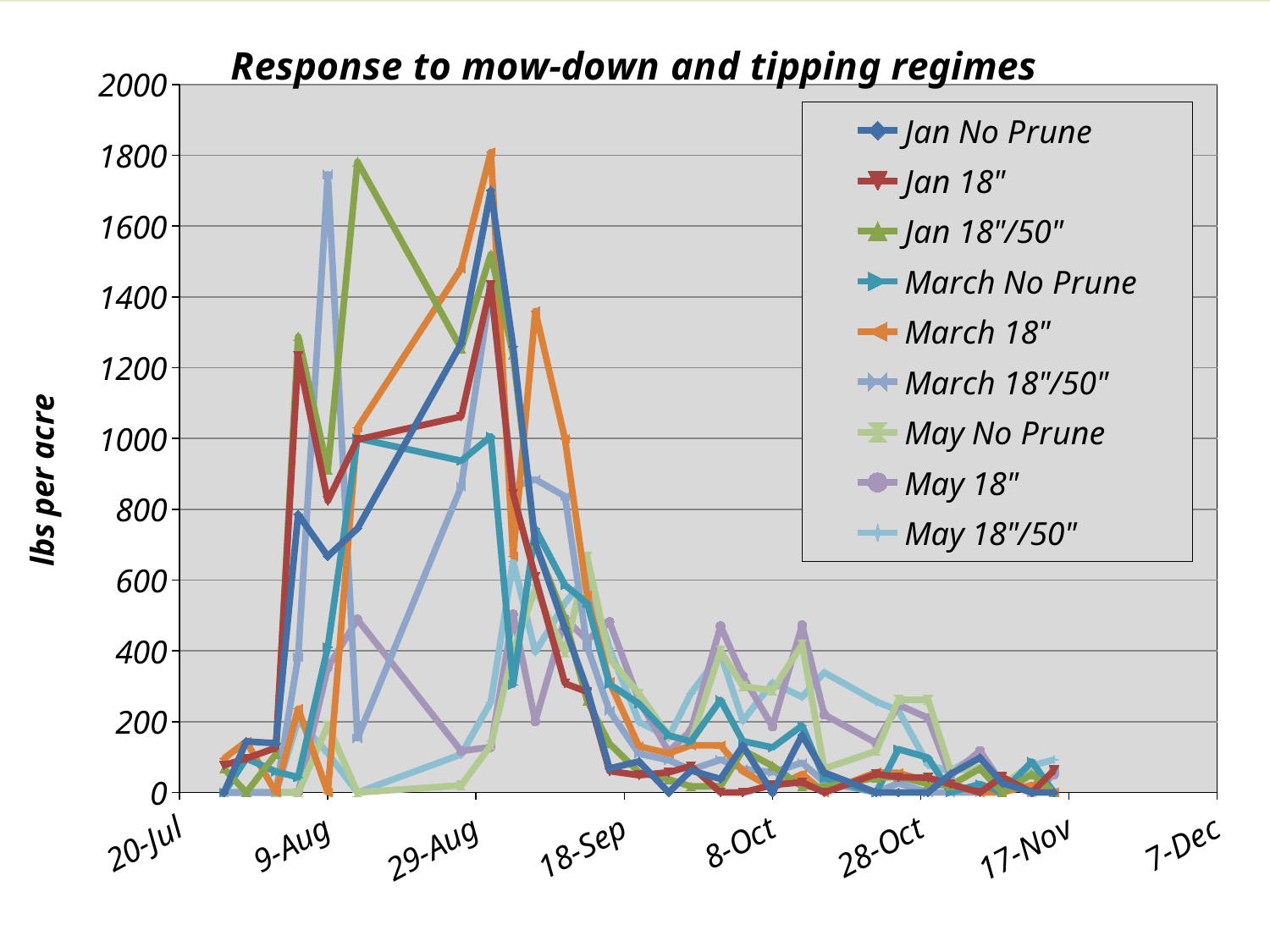
Is the peak value of the March 18" series greater or less than 1600? greater Is the peak value of the May No Prune series greater or less than 1000? less Is the peak value of the May 18" series greater or less than 800? less What is the label on the vertical axis? lbs per acre What is the title of the chart? Response to mow-down and tipping regimes Which series is plotted in orange? March 18" How many date labels are shown along the x axis? 8 What is the highest value shown on the vertical axis? 2000 Do the values for the March 18" series rise or fall between 29-Aug and 18-Sep? fall What kind of chart is shown on the slide? line chart How many series does the legend list? 9